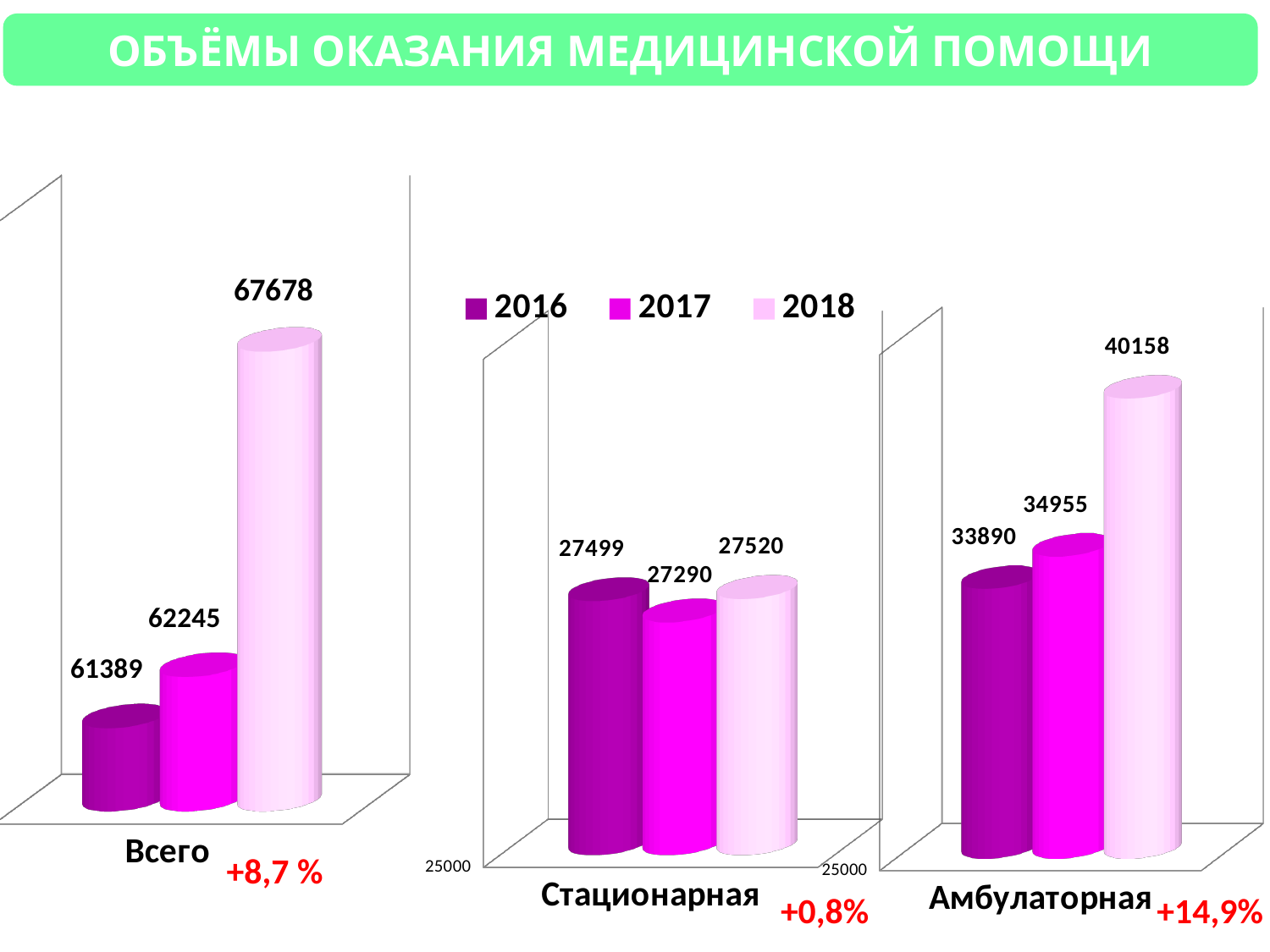
In the right chart (Амбулаторная), what is the value for 2018? 40158 In the left chart (Всего), which is larger, the value for 2017 or the value for 2016? 2017 In the middle chart (Стационарная), what is the value for 2017? 27290 In the left chart (Всего), what is the difference between the 2018 and 2017 values? 5433 In the right chart (Амбулаторная), which year has the highest value? 2018 In the right chart (Амбулаторная), what is the difference between the 2017 and 2016 values? 1065 What kind of chart is the left chart (Всего)? bar chart In the right chart (Амбулаторная), do the values rise or fall from 2016 to 2018? rise In the left chart (Всего), what is the value for 2016? 61389 In the middle chart (Стационарная), which year has the lowest value? 2017 In the left chart (Всего), what is the value for 2018? 67678 How many series does the legend list? 3